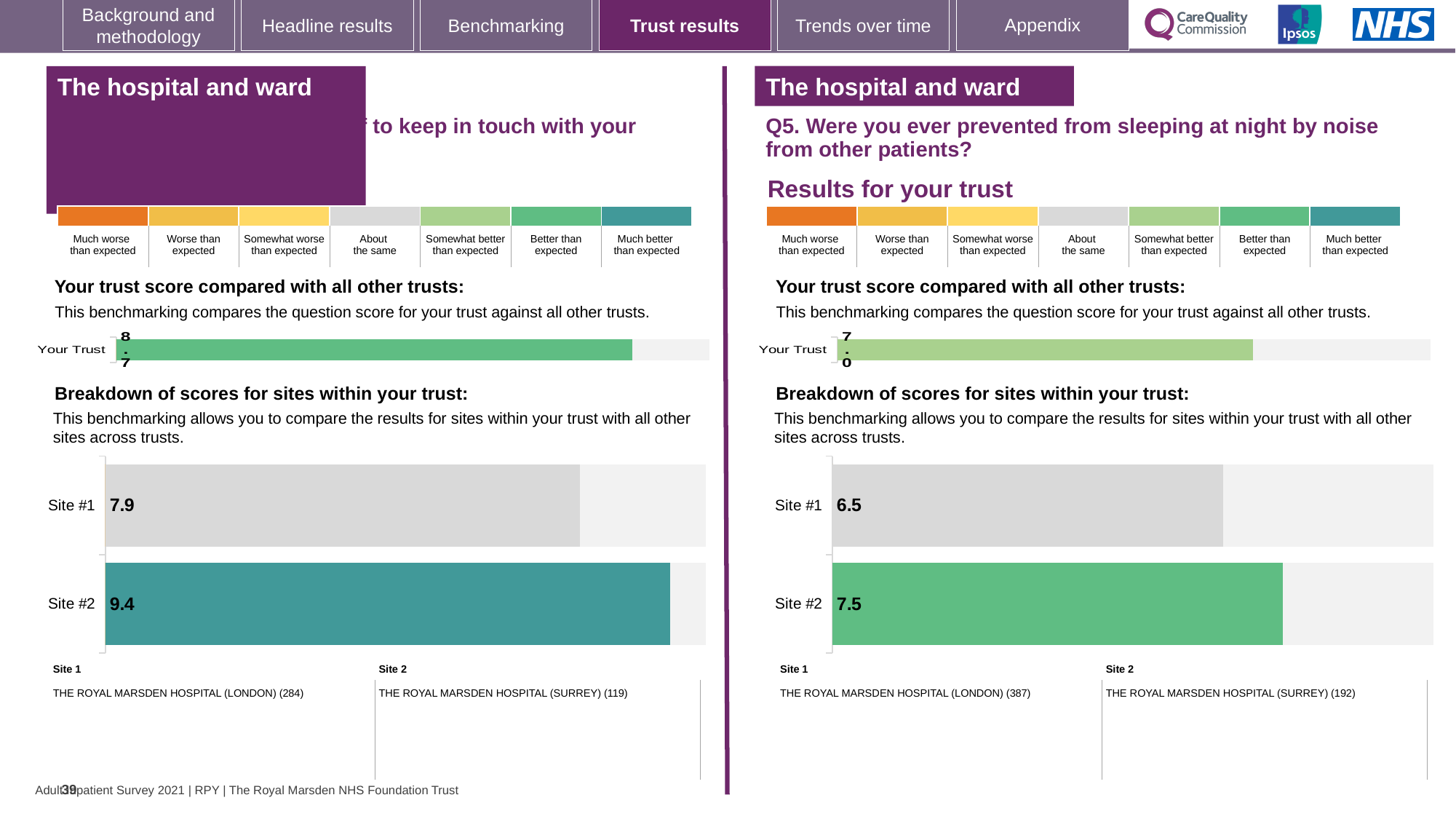
How many sites are shown in the site breakdown chart on the right-hand side (Q5)? 2 On the left-hand chart, which site has the lower score? Site #1 On the right-hand chart (Q5), what is the difference between the Site #2 and Site #1 scores? 1.0 On the right-hand chart (Q5), which site has the higher score? Site #2 On the left-hand chart, what is the score for Site #2? 9.4 On the left-hand chart, what is the difference between the Site #2 and Site #1 scores? 1.5 On the right-hand chart (Q5), what is the 'Your Trust' score? 7.0 On the right-hand chart (Q5, prevented from sleeping by noise from other patients), what is the score for Site #1? 6.5 On the right-hand chart (Q5), what is the score for Site #2? 7.5 On the left-hand chart, what is the score for Site #1? 7.9 On the left-hand chart, what is the 'Your Trust' score? 8.7 What type of chart is used for the breakdown of scores for sites on the left-hand side? Bar chart